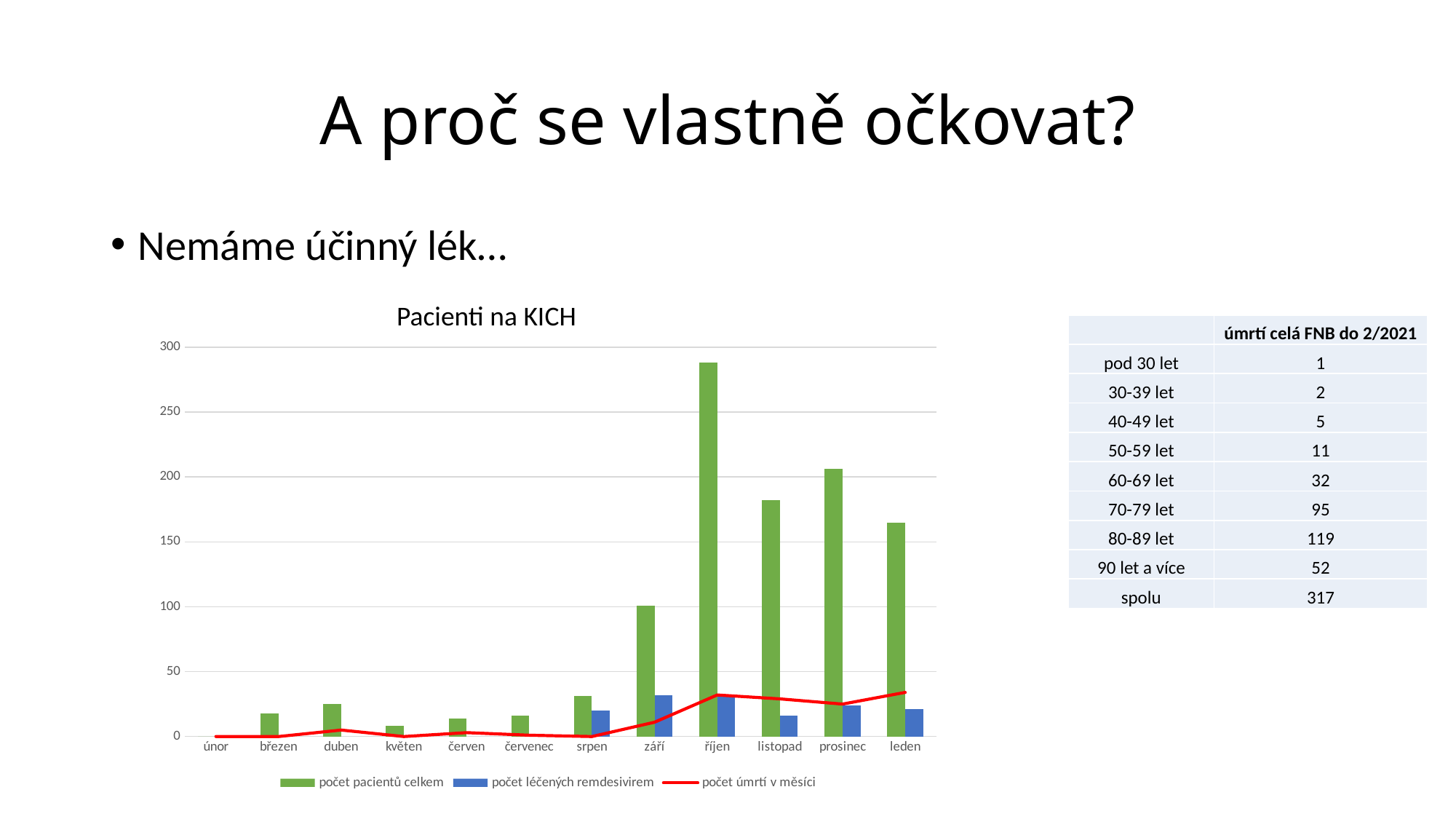
In the 'Pacienti na KICH' chart, which is larger for 'počet pacientů celkem': říjen or prosinec? říjen How many series does the legend of the 'Pacienti na KICH' chart list? 3 In the 'Pacienti na KICH' chart, is the value for 'počet pacientů celkem' in listopad greater or less than 150? greater In the 'Pacienti na KICH' chart, which month has the highest value for 'počet pacientů celkem'? říjen How many months are shown on the x axis of the 'Pacienti na KICH' chart? 12 What is the title of the chart on the slide? Pacienti na KICH In the 'Pacienti na KICH' chart, is the value for 'počet pacientů celkem' in říjen greater or less than 250? greater What kind of chart is 'Pacienti na KICH'? bar chart with a line In the 'Pacienti na KICH' chart, which is larger for 'počet léčených remdesivirem': září or listopad? září In the 'Pacienti na KICH' chart, does 'počet pacientů celkem' rise or fall from září to říjen? rise In the 'Pacienti na KICH' chart, which series is drawn as the red line? počet úmrtí v měsíci In the 'Pacienti na KICH' chart, is the value for 'počet pacientů celkem' in srpen greater or less than 50? less